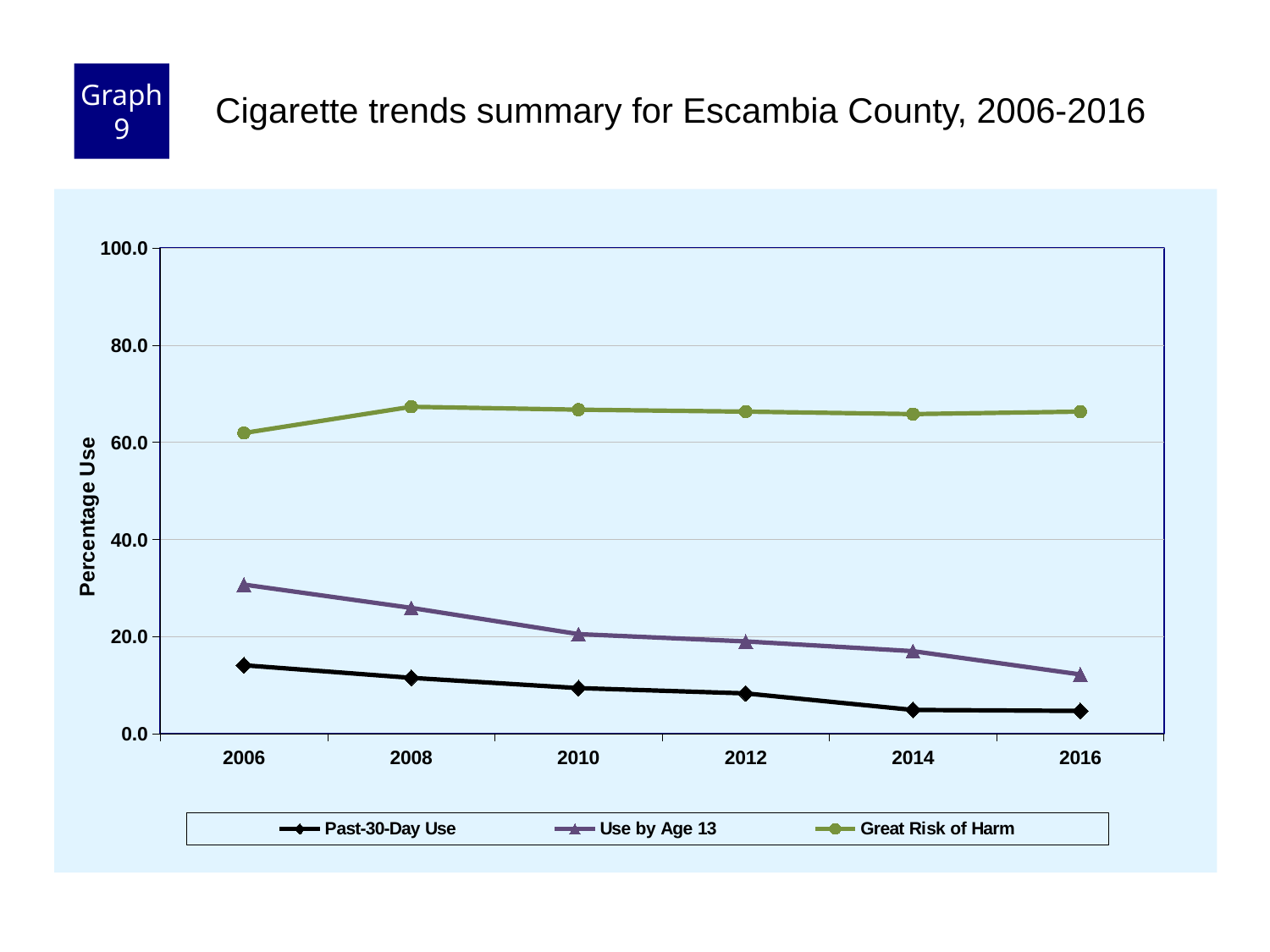
Is the value for Great Risk of Harm in 2008 greater or less than 60.0? greater In which year is the Great Risk of Harm value lowest? 2006 In which year is the Use by Age 13 value highest? 2006 What kind of chart is shown on the slide? line chart Is the value for Past-30-Day Use in 2016 greater or less than 20.0? less How many years are plotted along the x axis? 6 How many series does the legend list? 3 In which year is the Use by Age 13 value lowest? 2016 Is the value for Use by Age 13 in 2006 greater or less than 20.0? greater What is the label on the y axis? Percentage Use Does the Past-30-Day Use series rise or fall from 2006 to 2016? fall Which series has the highest values across all years? Great Risk of Harm